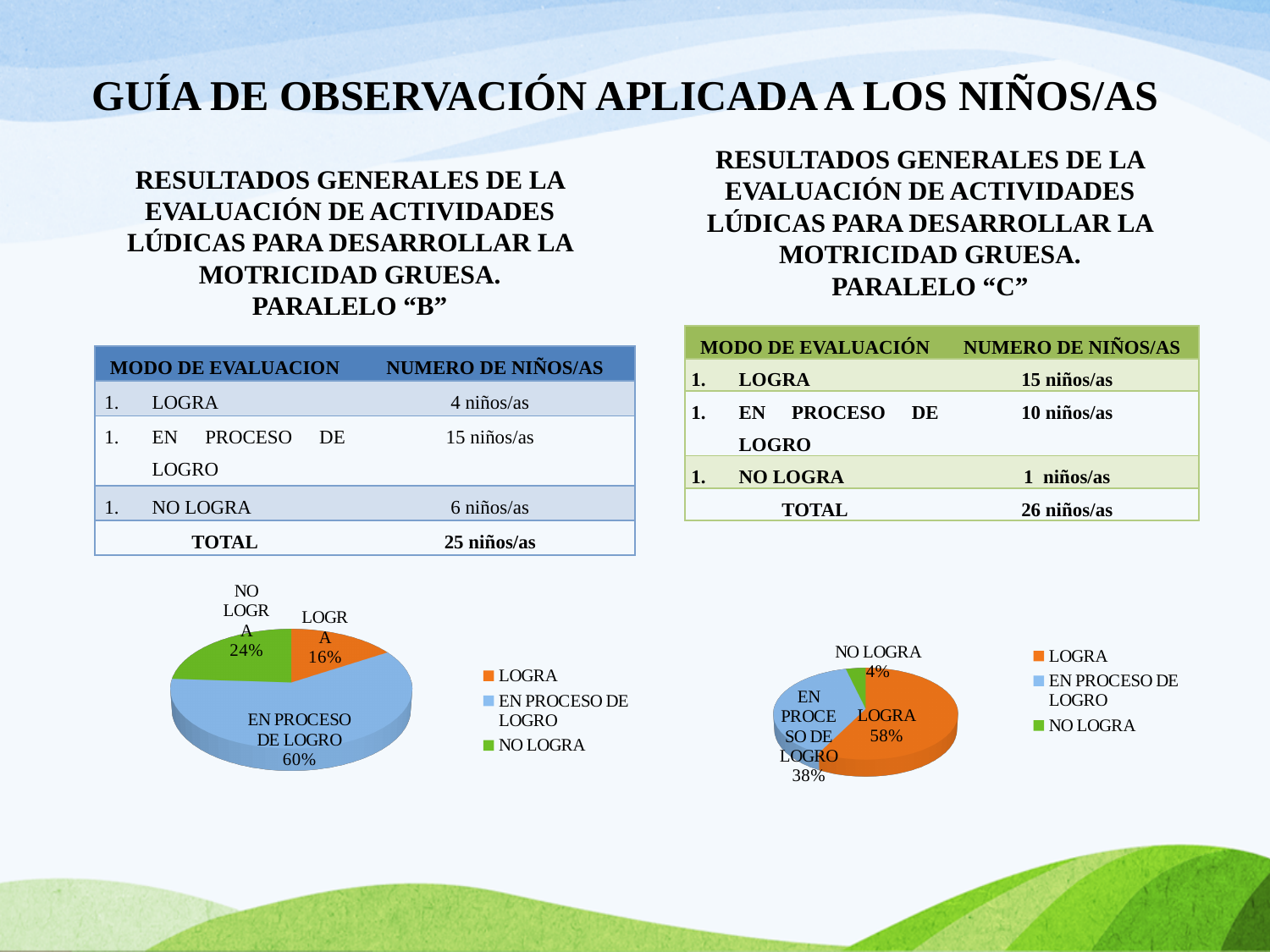
In the left pie chart (Paralelo "B"), which category has the smallest slice? LOGRA In the left pie chart (Paralelo "B"), which category has the largest slice? EN PROCESO DE LOGRO What type of chart is used on the left for Paralelo "B"? Pie chart In the right pie chart (Paralelo "C"), which category has the smallest slice? NO LOGRA In the right pie chart (Paralelo "C"), which is larger, LOGRA or EN PROCESO DE LOGRO? LOGRA In the right pie chart (Paralelo "C"), what percentage is shown for NO LOGRA? 4% In the left pie chart (Paralelo "B"), what share does EN PROCESO DE LOGRO have? 60% How many categories does the right pie chart (Paralelo "C") show? 3 In the right pie chart (Paralelo "C"), what share does LOGRA have? 58% In the left pie chart (Paralelo "B"), what percentage is shown for LOGRA? 16% In the left pie chart (Paralelo "B"), what is the difference in percentage points between EN PROCESO DE LOGRO and NO LOGRA? 36 In the left pie chart (Paralelo "B"), what percentage is shown for NO LOGRA? 24%